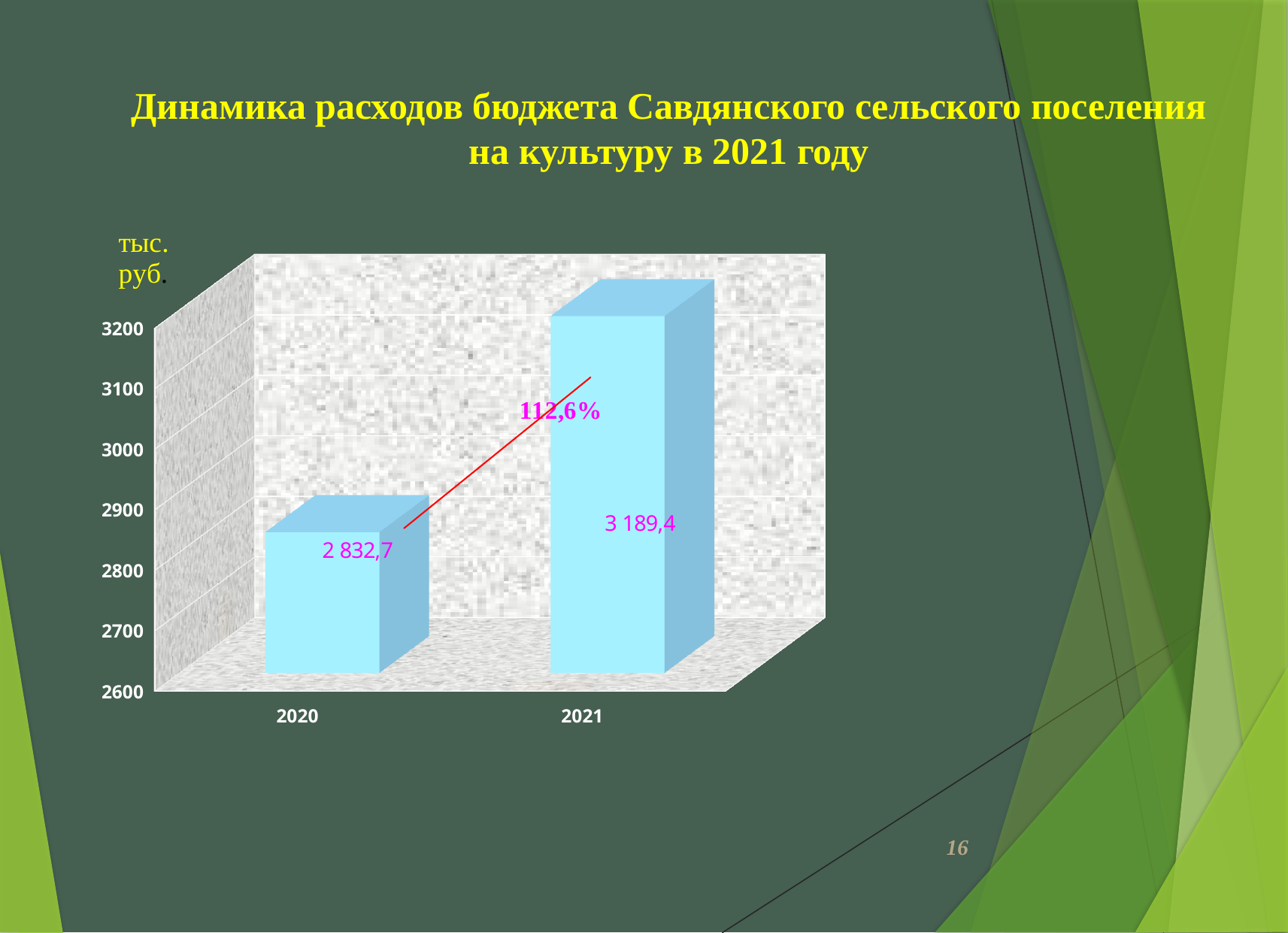
Is the value for 2021 larger than the value for 2020? Yes How many years are shown on the x axis? 2 Which year has the higher value? 2021 What is the value for 2021? 3 189,4 What percentage is written next to the red arrow between the two bars? 112,6% What kind of chart is shown on the slide? Bar chart Do the values rise or fall from 2020 to 2021? Rise Is the value for 2020 greater or less than 2900? less Is the value for 2021 greater or less than 3100? greater Which year has the lower value? 2020 What is the value for 2020? 2 832,7 What is the difference between the 2021 value and the 2020 value? 356,7